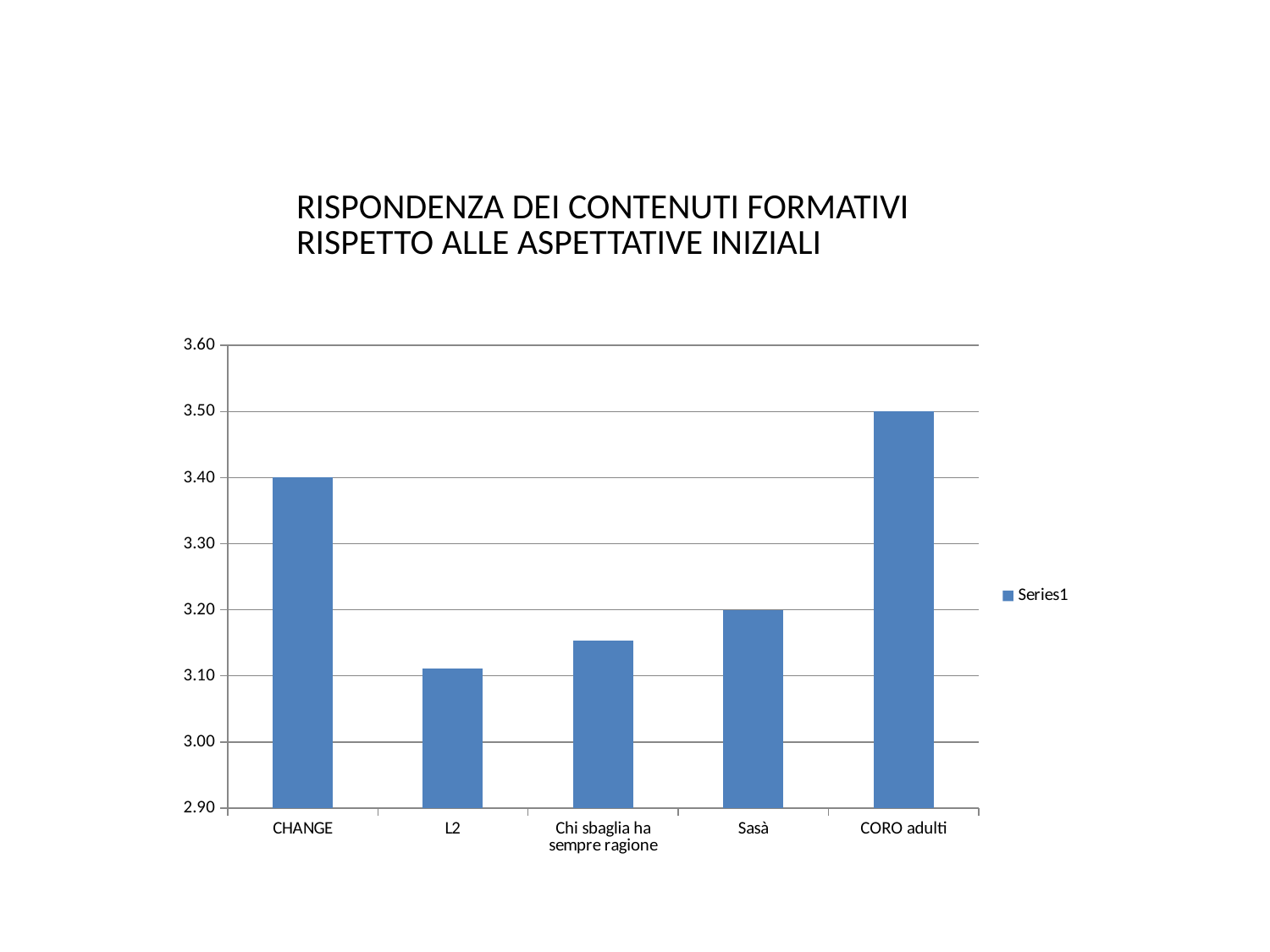
How many series does the legend list? 1 Which is larger, the value for CHANGE or the value for Sasà? CHANGE Which category has the lowest value? L2 What is the difference between the values for CORO adulti and CHANGE? 0.10 Is the value for L2 greater or less than 3.20? less What type of chart is shown on the slide? bar chart How many categories are shown on the x axis of the chart? 5 Which category has the highest value? CORO adulti What is the value for CORO adulti? 3.50 What is the title of the chart? RISPONDENZA DEI CONTENUTI FORMATIVI RISPETTO ALLE ASPETTATIVE INIZIALI What is the value for CHANGE? 3.40 What is the value for Sasà? 3.20